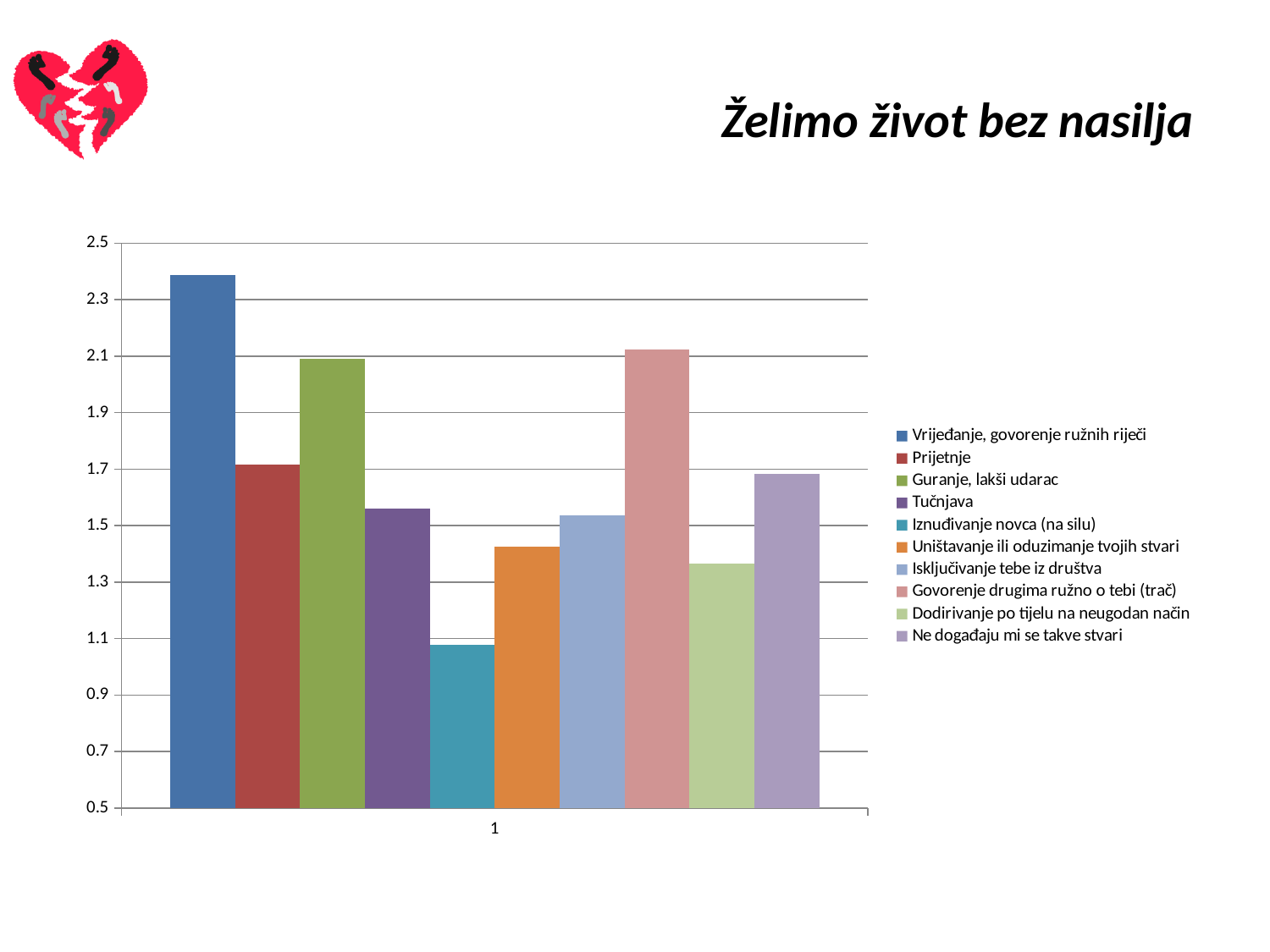
Is the value for Iznuđivanje novca (na silu) greater or less than 1.3? less Is the value for Guranje, lakši udarac greater or less than 1.9? greater Which series has the lowest bar? Iznuđivanje novca (na silu) Which is larger, the value for Vrijeđanje, govorenje ružnih riječi or the value for Govorenje drugima ružno o tebi (trač)? Vrijeđanje, govorenje ružnih riječi Is the value for Govorenje drugima ružno o tebi (trač) greater or less than 1.9? greater How many series does the legend list? 10 What is the title shown on the slide above the chart? Želimo život bez nasilja Which is larger, the value for Prijetnje or the value for Tučnjava? Prijetnje What kind of chart is shown on the slide? bar chart Which series has the highest bar? Vrijeđanje, govorenje ružnih riječi